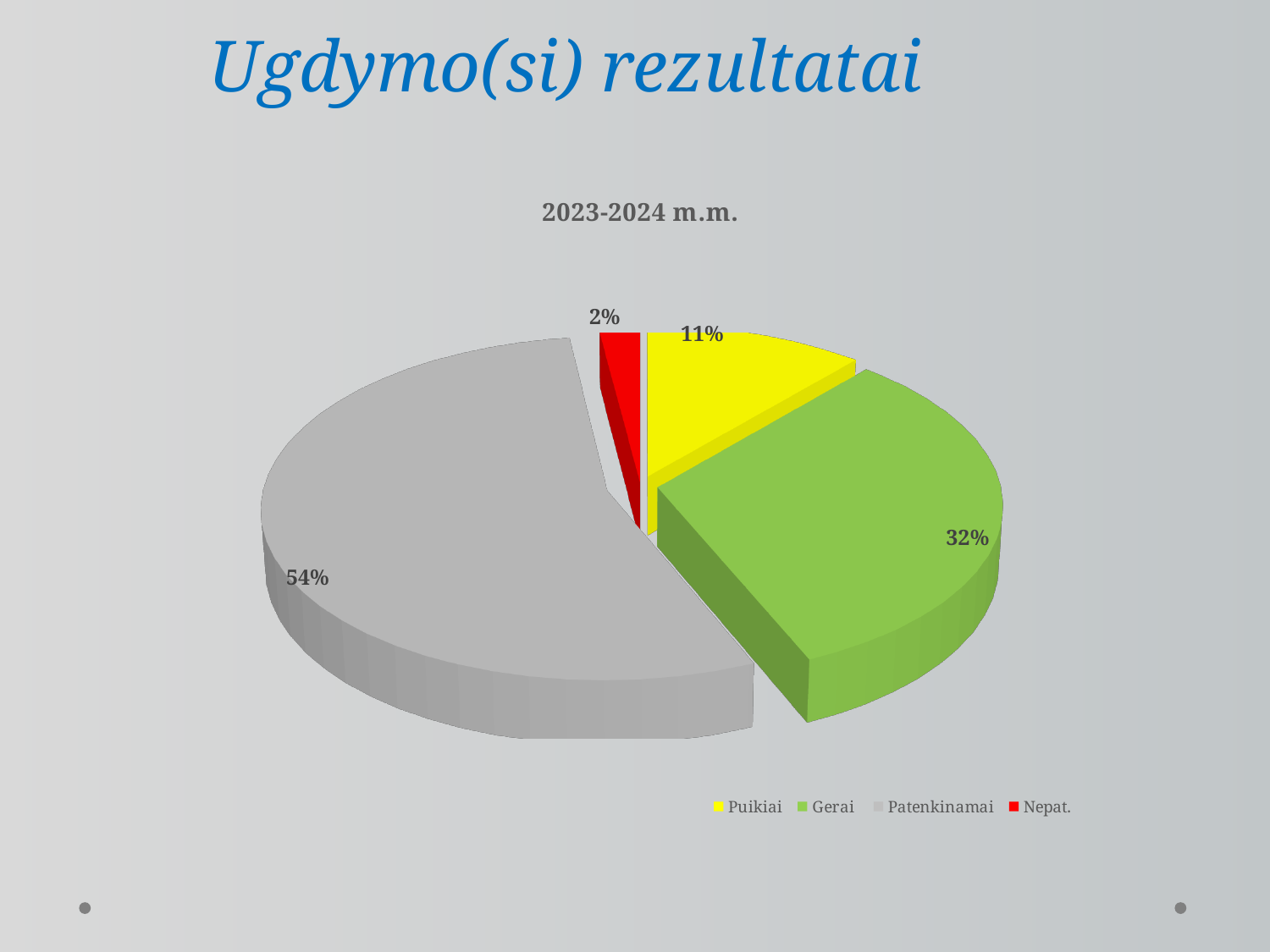
Which category has the smallest slice? Nepat. Which category has the largest slice? Patenkinamai What share of the pie does Nepat. have? 2% Which is larger, the Gerai slice or the Puikiai slice? Gerai What is the difference between the Patenkinamai and Gerai shares? 22% Which colour represents Nepat. in the legend? red What kind of chart is shown on the slide? pie chart What share of the pie does Patenkinamai have? 54% What share of the pie does Gerai have? 32% How many categories does the pie chart have? 4 What is the chart's title? 2023-2024 m.m.